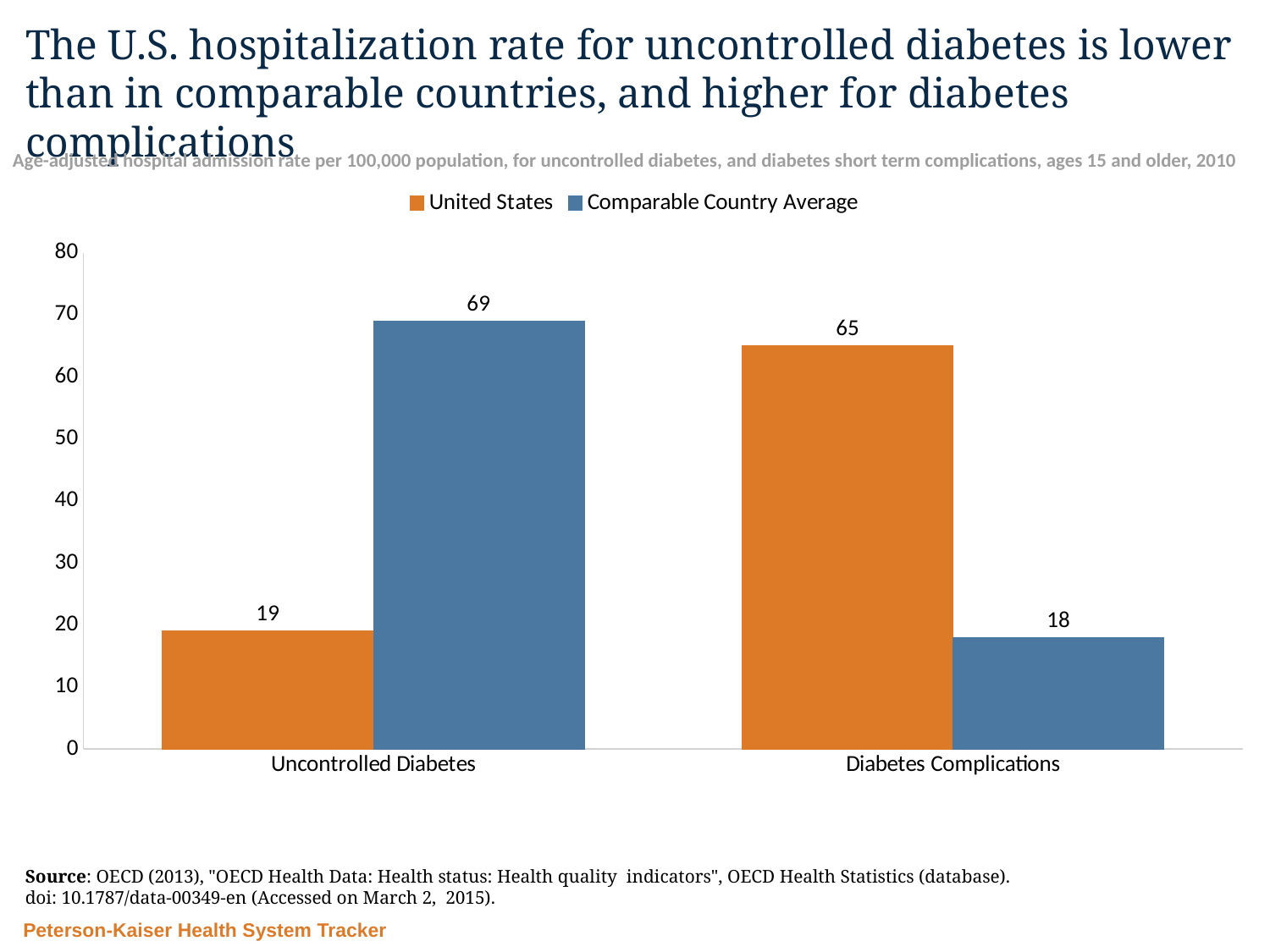
What is the value for United States for Uncontrolled Diabetes? 19 How many categories are shown on the x axis? 2 What is the difference between the United States and the Comparable Country Average for Diabetes Complications? 47 Which category has the lowest value for the United States series? Uncontrolled Diabetes What is the value for Comparable Country Average for Uncontrolled Diabetes? 69 Which category has the highest value for the Comparable Country Average series? Uncontrolled Diabetes What is the difference between the Comparable Country Average and the United States for Uncontrolled Diabetes? 50 What kind of chart is shown on the slide? Bar chart What is the value for Comparable Country Average for Diabetes Complications? 18 What is the value for United States for Diabetes Complications? 65 How many series does the legend list? 2 For Diabetes Complications, which is larger: the United States or the Comparable Country Average? United States